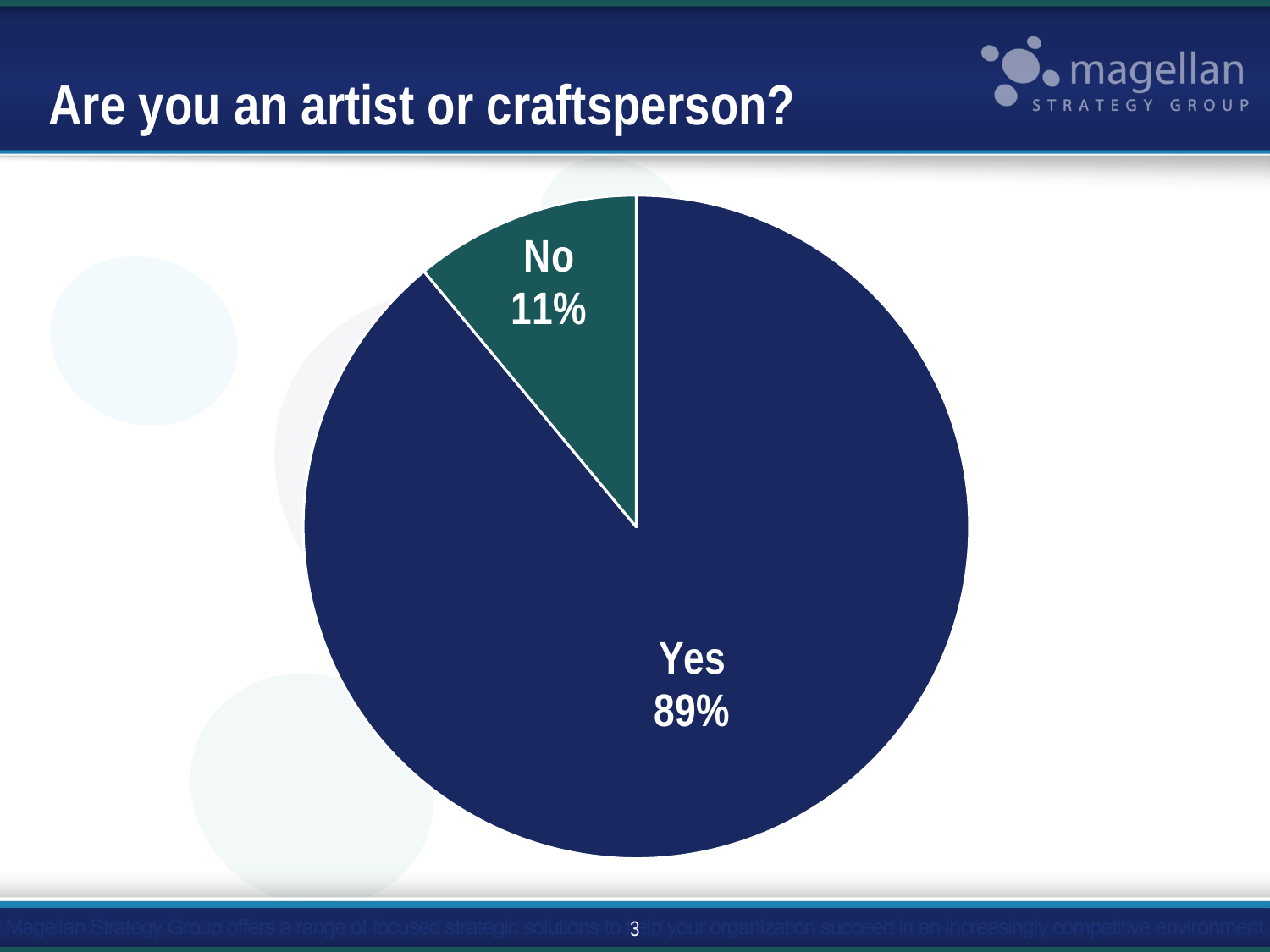
What question does the slide title ask? Are you an artist or craftsperson? What kind of chart is shown on the slide? Pie chart What percentage of respondents answered "No"? 11% What share of the pie does the "No" slice represent? 11% What percentage of respondents answered "Yes"? 89% What colour is the "Yes" slice of the pie? Dark blue What is the difference in percentage points between the "Yes" and "No" slices? 78 Which slice of the pie is the largest? Yes Which slice of the pie is the smallest? No Which is larger, the "Yes" slice or the "No" slice? Yes How many slices does the pie chart have? 2